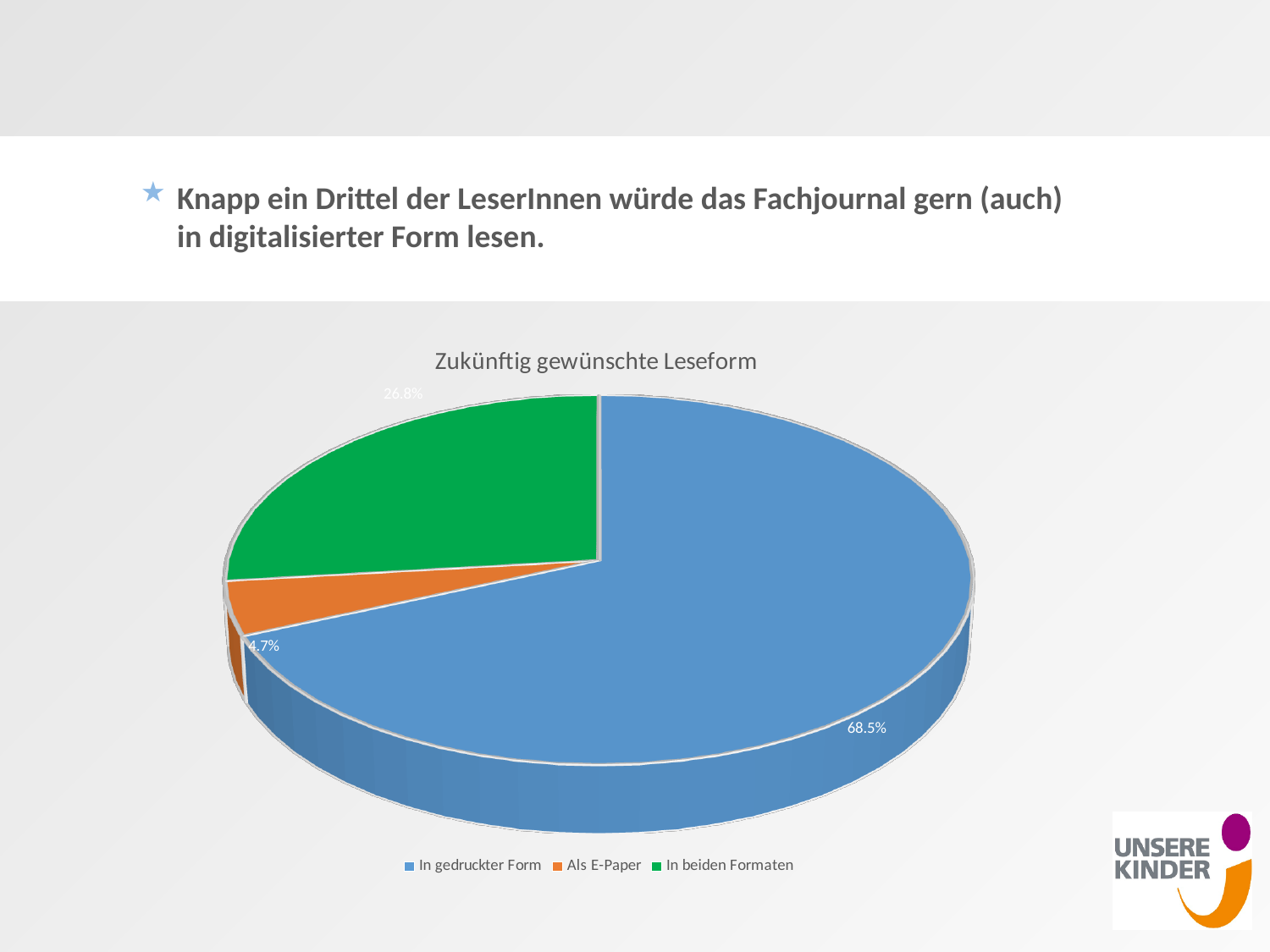
Which category has the smallest slice of the pie? Als E-Paper How many slices does the pie chart have? 3 What share of the pie is 'Als E-Paper'? 4.7% What share of the pie is 'In gedruckter Form'? 68.5% What colour is the slice for 'Als E-Paper'? orange How many entries does the legend list? 3 What is the difference between the share for 'In gedruckter Form' and the share for 'In beiden Formaten'? 41.7% What kind of chart is shown on the slide? pie chart What is the title of the chart? Zukünftig gewünschte Leseform Which is larger, the slice for 'In beiden Formaten' or the slice for 'Als E-Paper'? In beiden Formaten What share of the pie is 'In beiden Formaten'? 26.8% Which category has the largest slice of the pie? In gedruckter Form